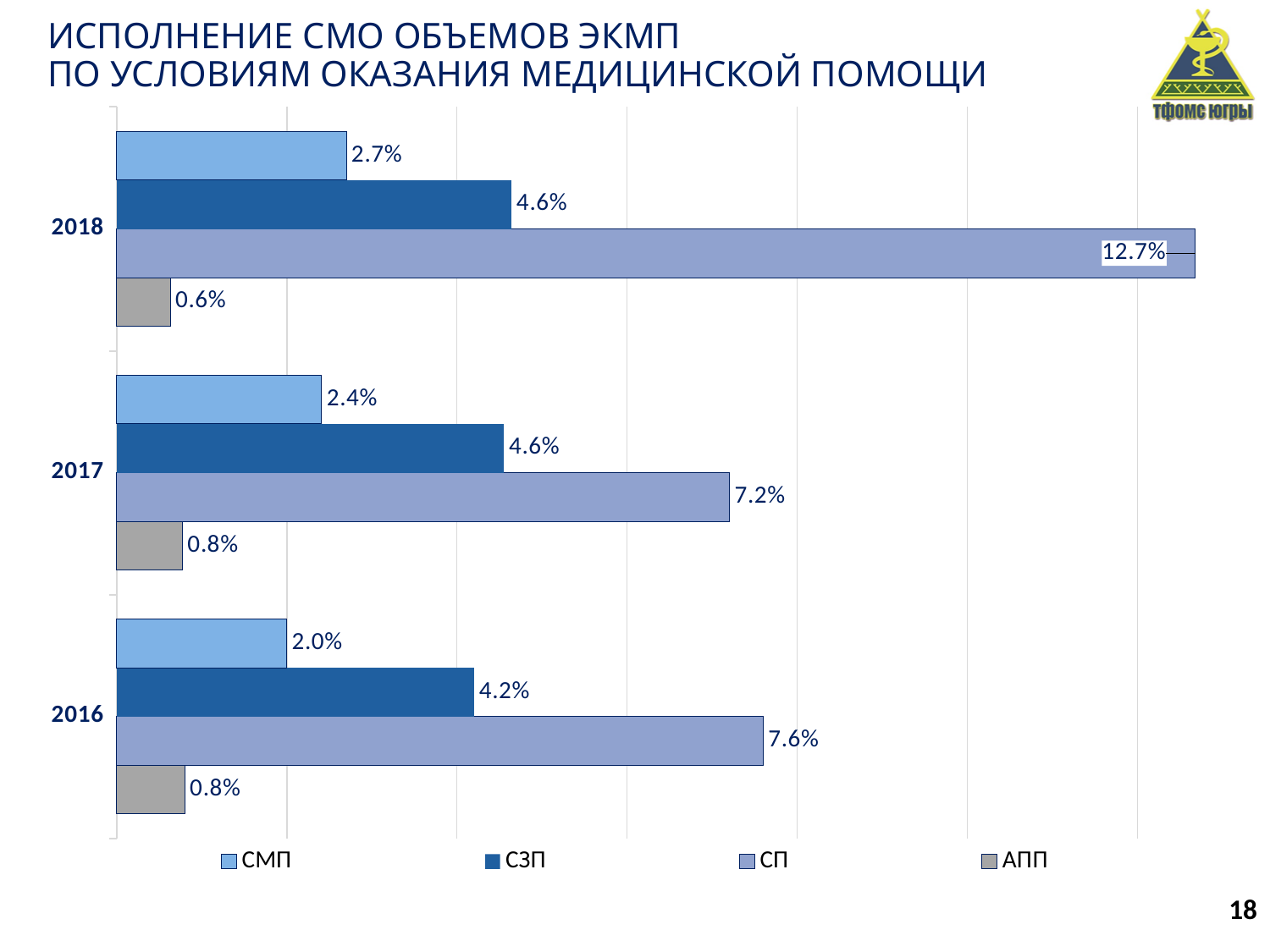
Which series has the highest value in 2018? СП How many years are shown on the chart? 3 What kind of chart is shown on the slide? Bar chart What is the value for СМП in 2016? 2.0% What is the difference between the СП values for 2018 and 2017? 5.5% Which is larger, the СП value for 2016 or for 2017? 2016 How many series does the legend list? 4 What is the value for АПП in 2017? 0.8% What is the value for СЗП in 2017? 4.6% What is the value for СП in 2018? 12.7% Does the СМП value rise or fall from 2016 to 2018? Rise Which series has the lowest value in 2016? АПП